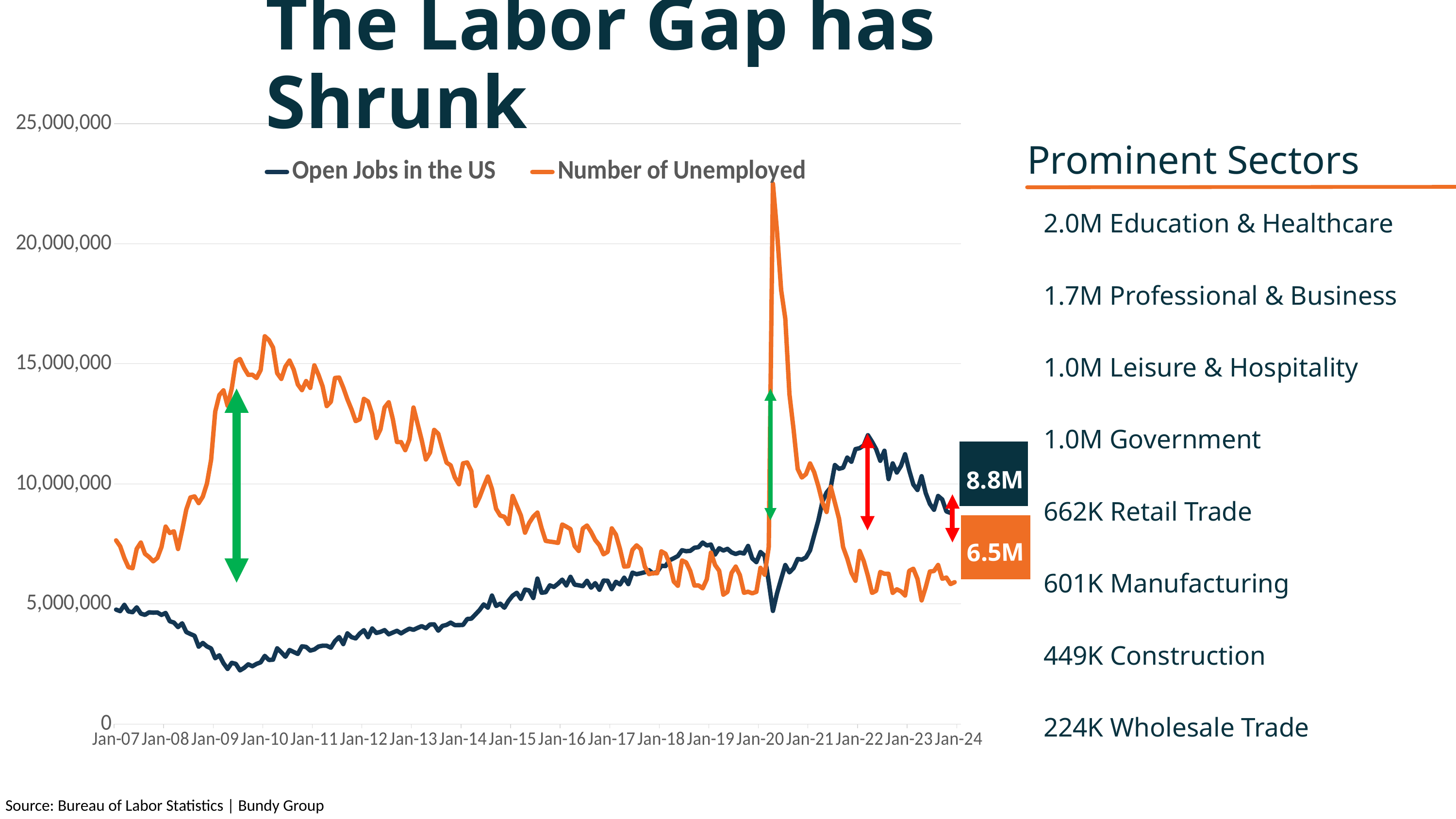
Is the value for Open Jobs in the US at Jan-10 greater or less than 5,000,000? less What is the title of the chart? The Labor Gap has Shrunk Between Jan-10 and Jan-19, does the Number of Unemployed line generally rise or fall? fall What is the labelled latest value for Open Jobs in the US at the right end of the chart? 8.8M At the right end of the chart (Jan-24), which series is higher: Open Jobs in the US or Number of Unemployed? Open Jobs in the US What are the two series named in the chart's legend? Open Jobs in the US; Number of Unemployed Is the peak value of Number of Unemployed around Jan-20 greater or less than 20,000,000? greater How many series does the chart's legend list? 2 Is the value for Number of Unemployed at Jan-10 greater or less than 10,000,000? greater What kind of chart is shown on the slide? line chart What is the labelled latest value for Number of Unemployed at the right end of the chart? 6.5M What is the difference between the labelled latest values for Open Jobs in the US (8.8M) and Number of Unemployed (6.5M)? 2.3M